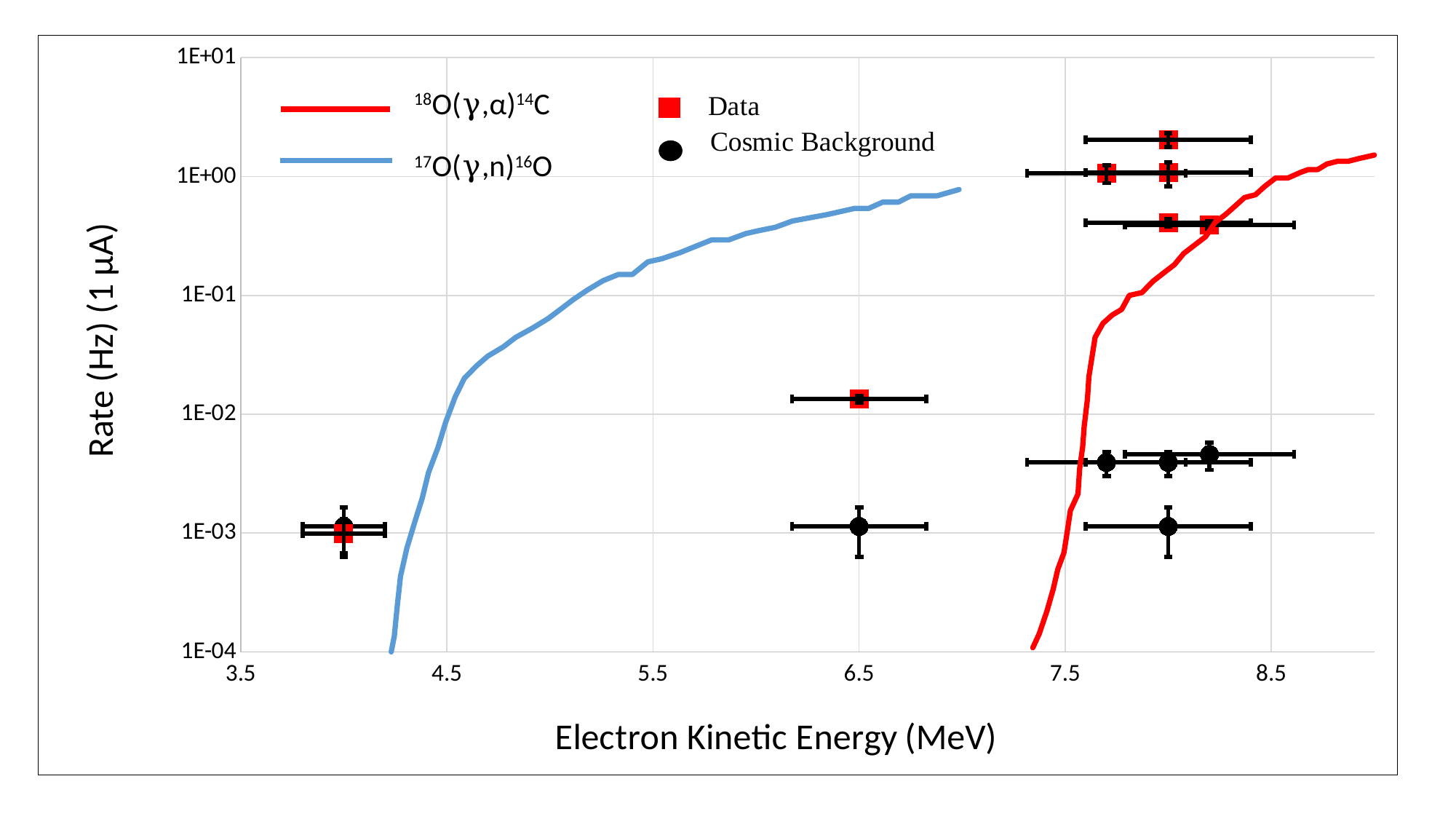
Is the Data point at 4.0 MeV greater or less than 1E-02 Hz? less At 6.5 MeV, which is larger: the Data point or the Cosmic Background point? Data Does the red 18O(γ,α)14C curve rise or fall as electron kinetic energy increases? Rise Is the Data point at 6.5 MeV greater or less than 1E-01 Hz? less How many entries does the legend list? 4 What is the title of the x axis? Electron Kinetic Energy (MeV) What is the title of the y axis? Rate (Hz) (1 μA) What kind of chart is shown on the slide? Line chart with scatter points (log scale) Which curve starts rising at a lower electron kinetic energy, the blue 17O(γ,n)16O curve or the red 18O(γ,α)14C curve? Blue 17O(γ,n)16O curve How many red Data points are plotted? 7 Is the Cosmic Background point at 6.5 MeV greater or less than 1E-02 Hz? less Does the blue 17O(γ,n)16O curve rise or fall as electron kinetic energy increases? Rise